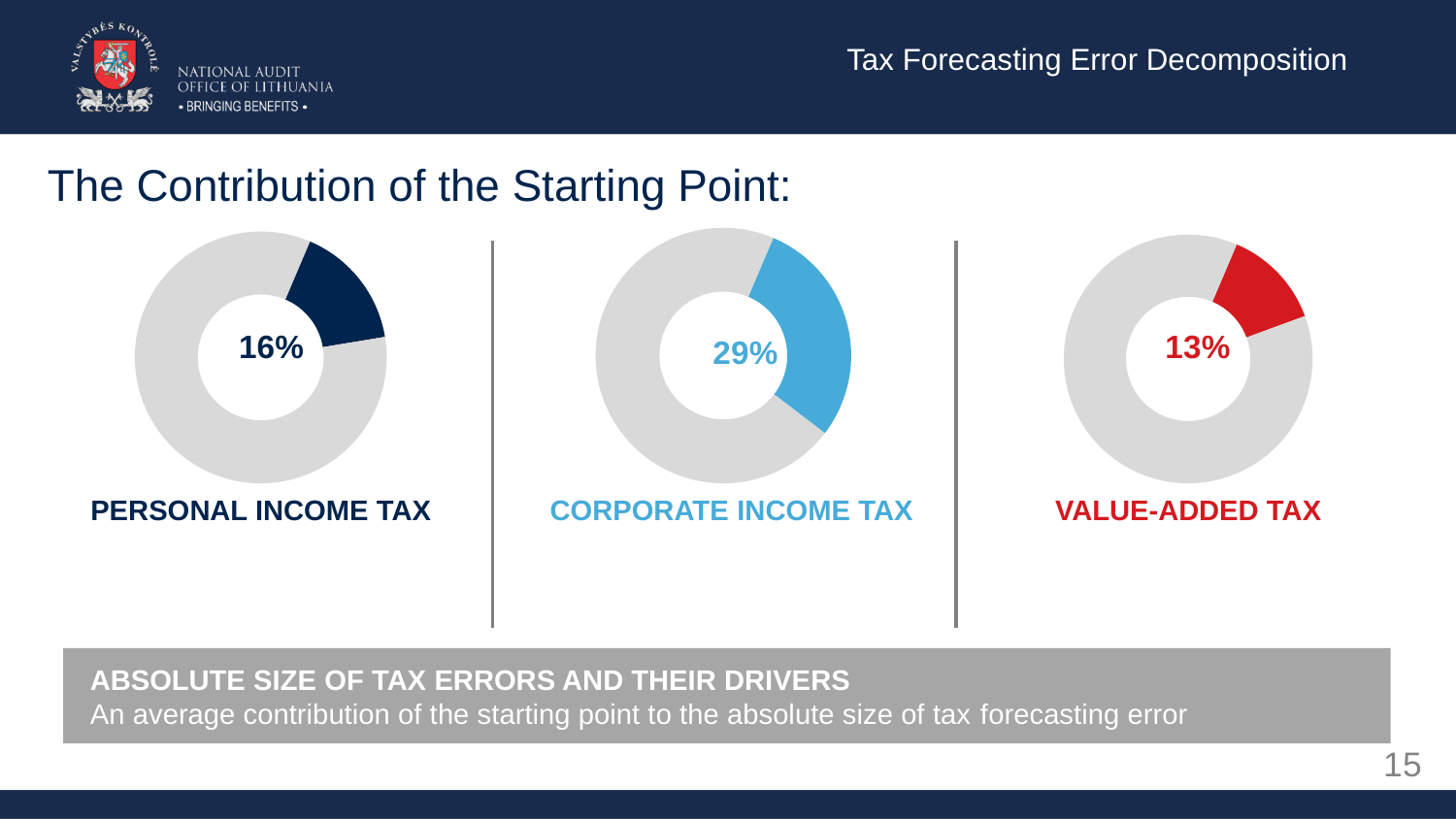
What percentage is shown in the Personal Income Tax donut chart? 16% What percentage is shown in the Corporate Income Tax donut chart? 29% What kind of chart is used to show the contribution of the starting point for each tax? Donut chart How many donut charts are shown on the slide? 3 What is the title of the slide above the three donut charts? The Contribution of the Starting Point: Which tax has the highest contribution of the starting point across the three donut charts? Corporate Income Tax What percentage is shown in the Value-Added Tax donut chart? 13% Which tax has the lowest contribution of the starting point across the three donut charts? Value-Added Tax What is the difference between the Personal Income Tax percentage and the Value-Added Tax percentage? 3% What colour is the highlighted slice in the Value-Added Tax donut chart? Red What is the difference between the Corporate Income Tax percentage and the Personal Income Tax percentage? 13% Which is larger, the Personal Income Tax percentage or the Value-Added Tax percentage? Personal Income Tax